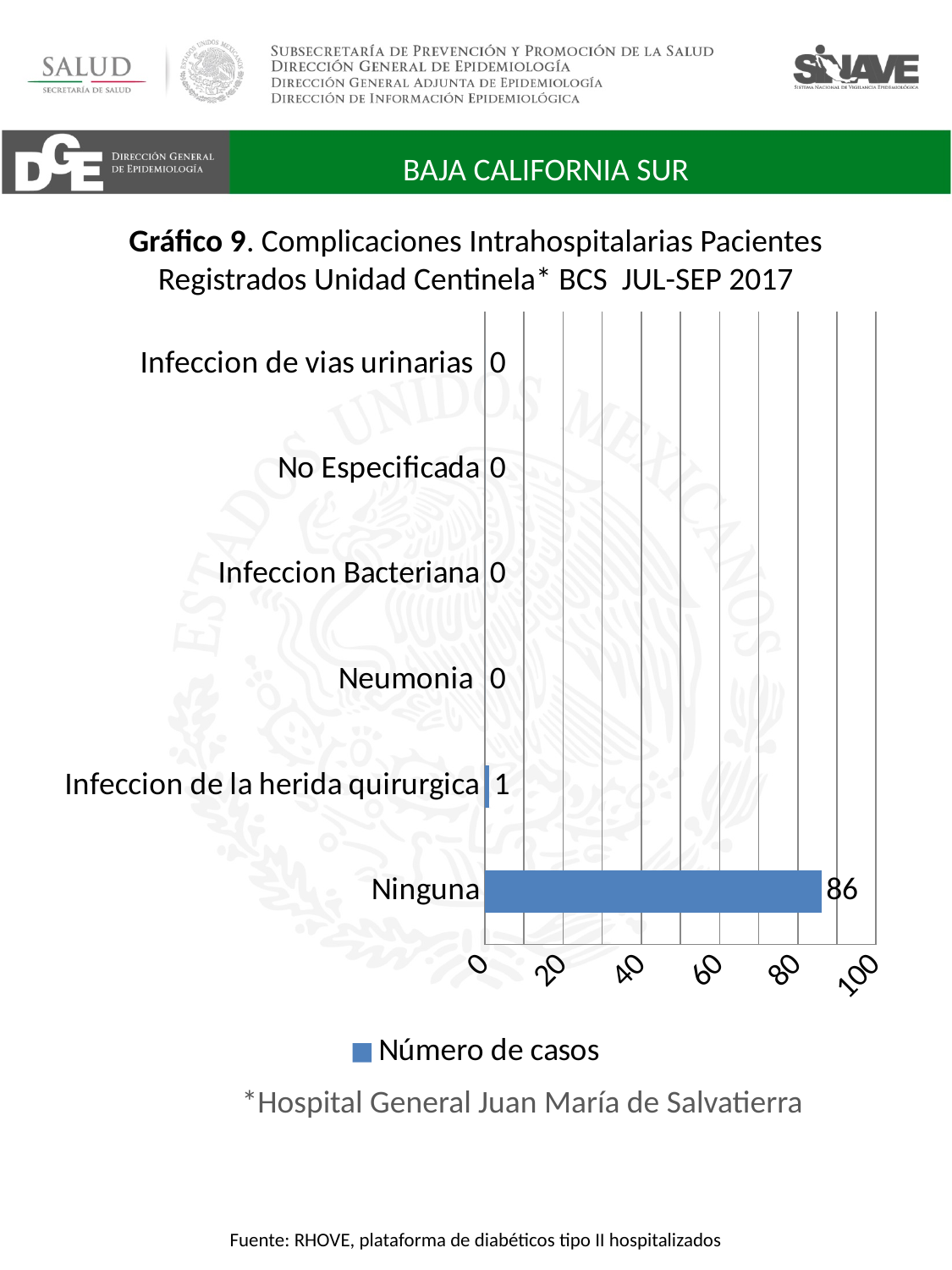
What kind of chart is shown? bar chart Is the value for Ninguna greater or less than 80? greater What is the number of cases for Ninguna? 86 How many series does the legend list? 1 How many categories are shown on the chart? 6 What is the number of cases for Neumonia? 0 Which category has the highest number of cases? Ninguna What is the number of cases for Infeccion de la herida quirurgica? 1 What is the legend entry for the series shown? Número de casos What is the difference in number of cases between Ninguna and Infeccion de la herida quirurgica? 85 Which has more cases, Ninguna or Infeccion Bacteriana? Ninguna What is the number of cases for Infeccion de vias urinarias? 0